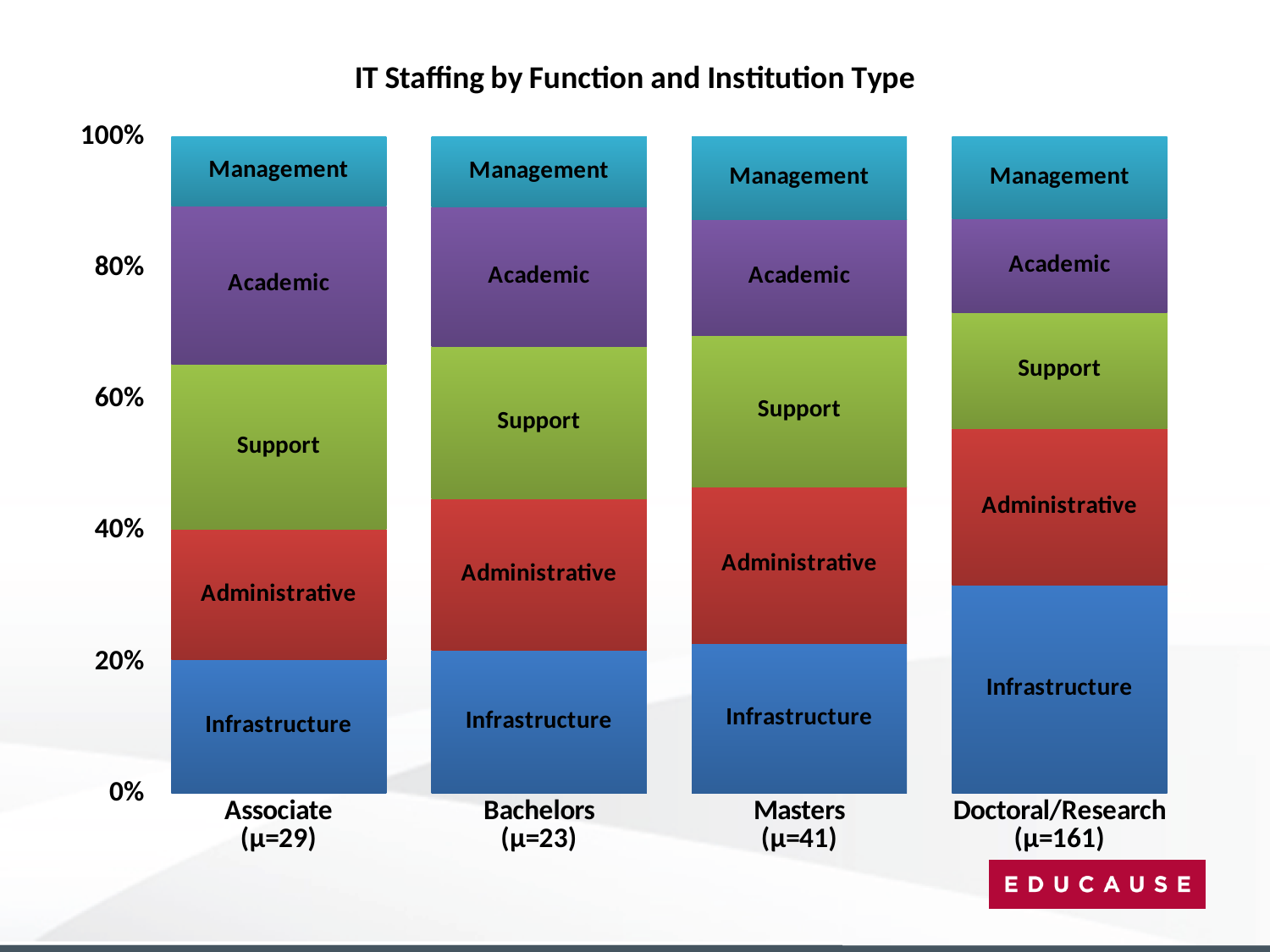
How many institution types are shown along the x axis? 4 How many IT function segments make up each stacked bar? 5 Which institution type has the smallest Support share? Doctoral/Research What kind of chart is shown on the slide? Stacked bar chart Which institution type has the largest Academic share? Associate Is the Infrastructure share for Doctoral/Research greater or less than 40%? less What is the sample size (μ) shown for Doctoral/Research? μ=161 Is the Infrastructure share for Doctoral/Research greater or less than 20%? greater Which institution type has the largest Infrastructure share? Doctoral/Research What is the total of the Associate stacked bar? 100% What is the title of the chart? IT Staffing by Function and Institution Type Which is larger, the Infrastructure share for Doctoral/Research or for Associate? Doctoral/Research